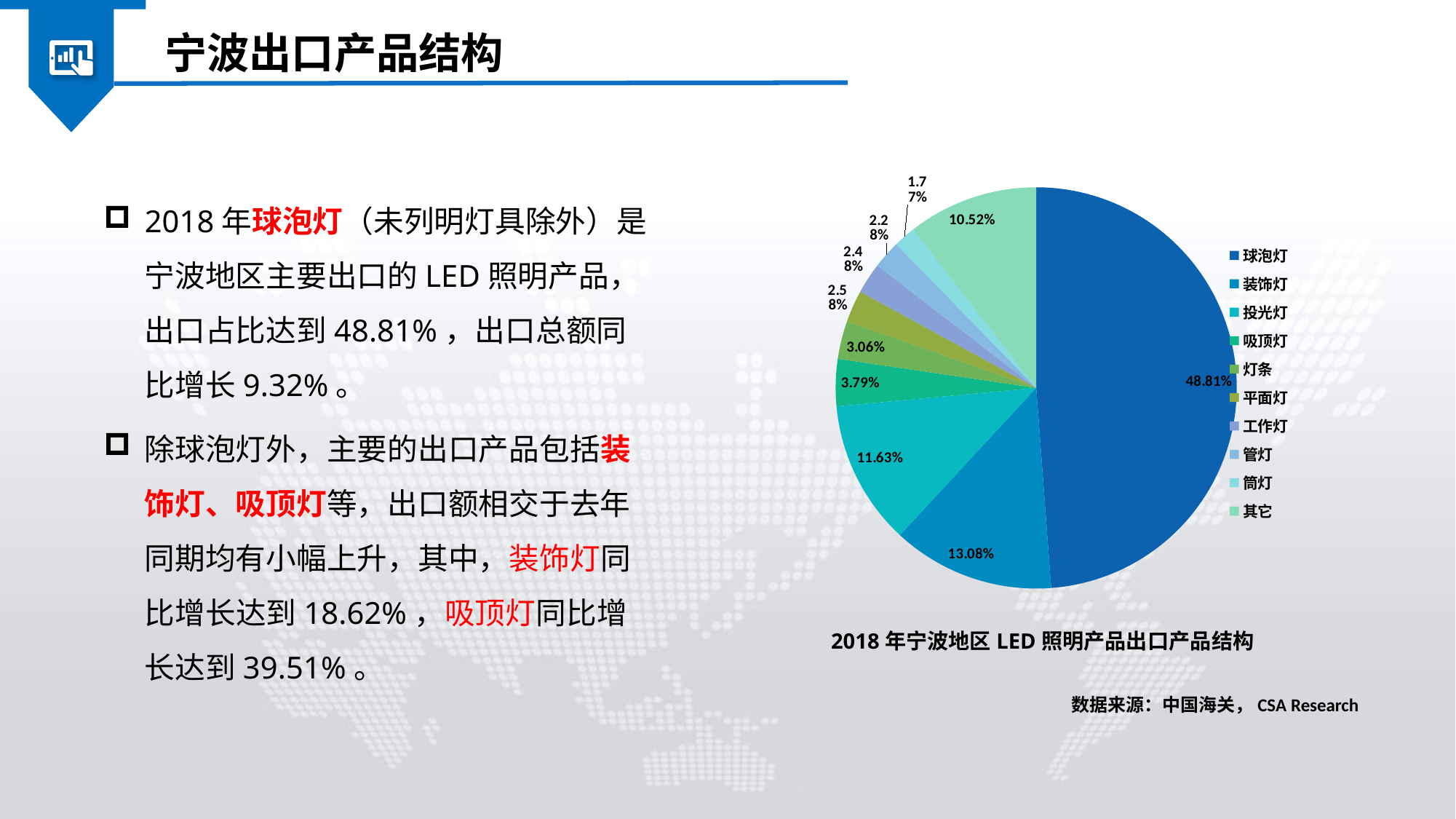
What is the difference in percentage points between 球泡灯 and 装饰灯? 35.73% What percentage is labelled for 投光灯? 11.63% What is the value for 吸顶灯 in the pie chart? 3.79% What type of chart is shown on the slide? Pie chart Which slice is larger, 投光灯 or 其它? 投光灯 What share of the pie does 球泡灯 account for? 48.81% How many categories does the legend list? 10 Which category has the largest slice of the pie? 球泡灯 Which category has the smallest slice of the pie? 筒灯 What is the title printed below the chart? 2018 年宁波地区 LED 照明产品出口产品结构 What share does the 其它 slice have? 10.52% What is the value shown for 装饰灯 in the pie chart? 13.08%